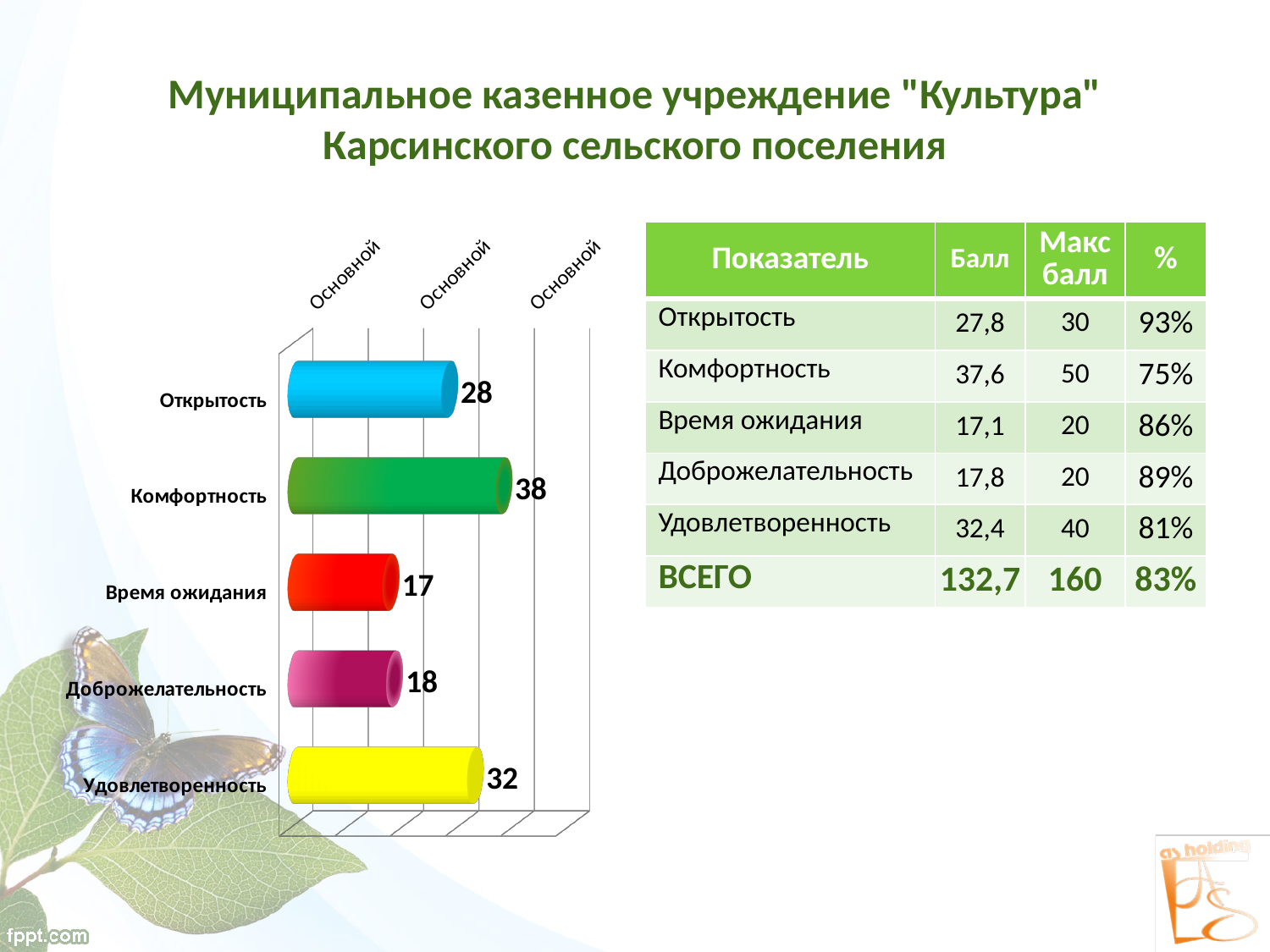
What value does the chart show for Открытость? 28 Which is larger in the chart, the value for Открытость or the value for Удовлетворенность? Удовлетворенность What is the difference between the values for Удовлетворенность and Доброжелательность in the chart? 14 How many categories are shown in the chart? 5 What is the difference between the values for Комфортность and Открытость in the chart? 10 Which category has the highest value in the chart? Комфортность What kind of chart is shown on the slide? Bar chart What colour is the bar for Время ожидания in the chart? Red What value does the chart show for Время ожидания? 17 What value does the chart show for Комфортность? 38 What value does the chart show for Удовлетворенность? 32 Which category has the lowest value in the chart? Время ожидания